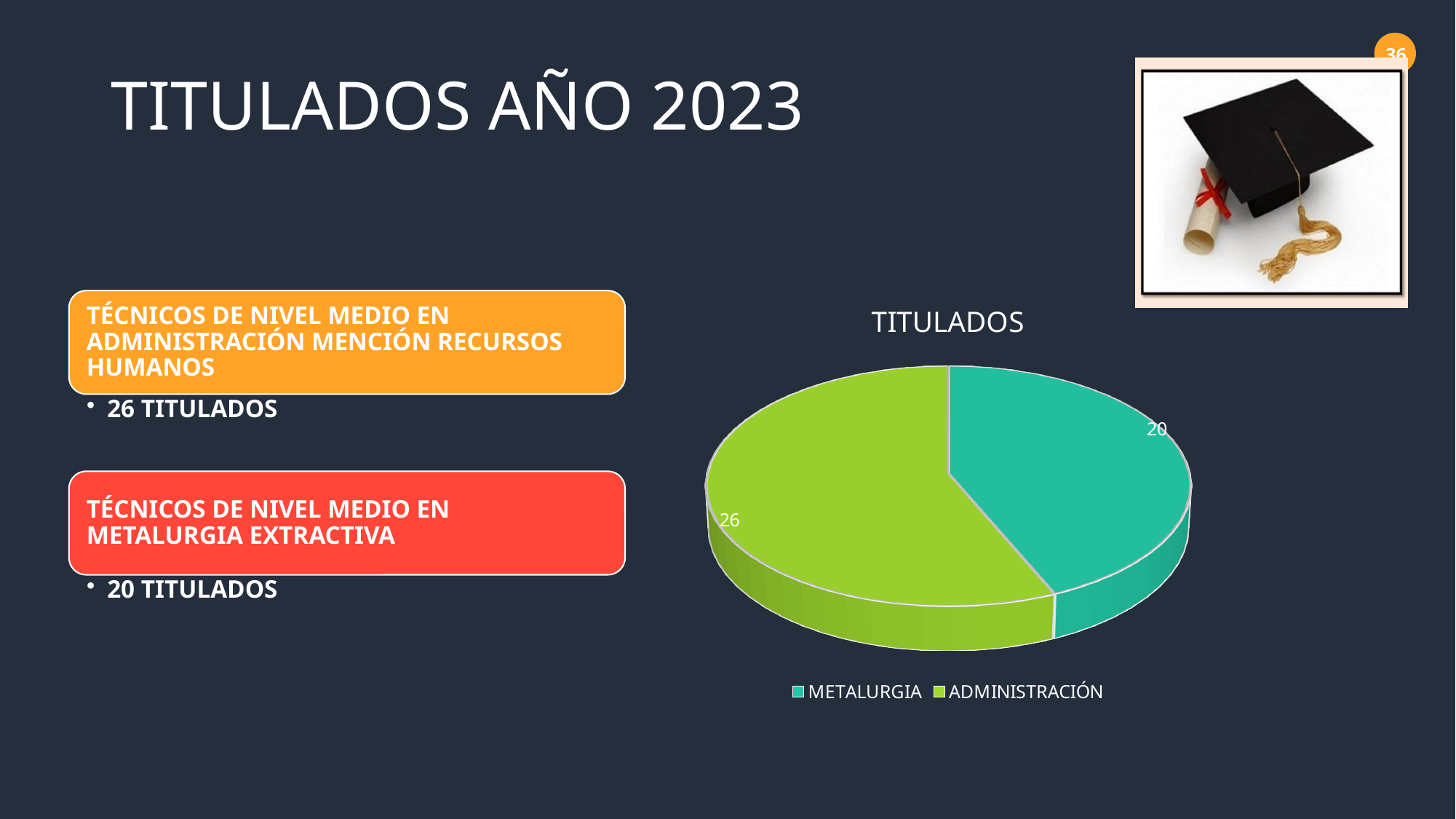
Which category has the largest slice in the pie chart? ADMINISTRACIÓN What is the title of the chart? TITULADOS What is the total of all slices in the pie chart? 46 What is the value for METALURGIA in the pie chart? 20 How many slices does the pie chart have? 2 Which category has the smallest slice in the pie chart? METALURGIA How many entries does the legend list? 2 What type of chart is shown on the slide? pie chart Which colour represents METALURGIA in the pie chart? teal Which is larger, the value for METALURGIA or the value for ADMINISTRACIÓN? ADMINISTRACIÓN What is the value for ADMINISTRACIÓN in the pie chart? 26 What is the difference between the values for ADMINISTRACIÓN and METALURGIA? 6